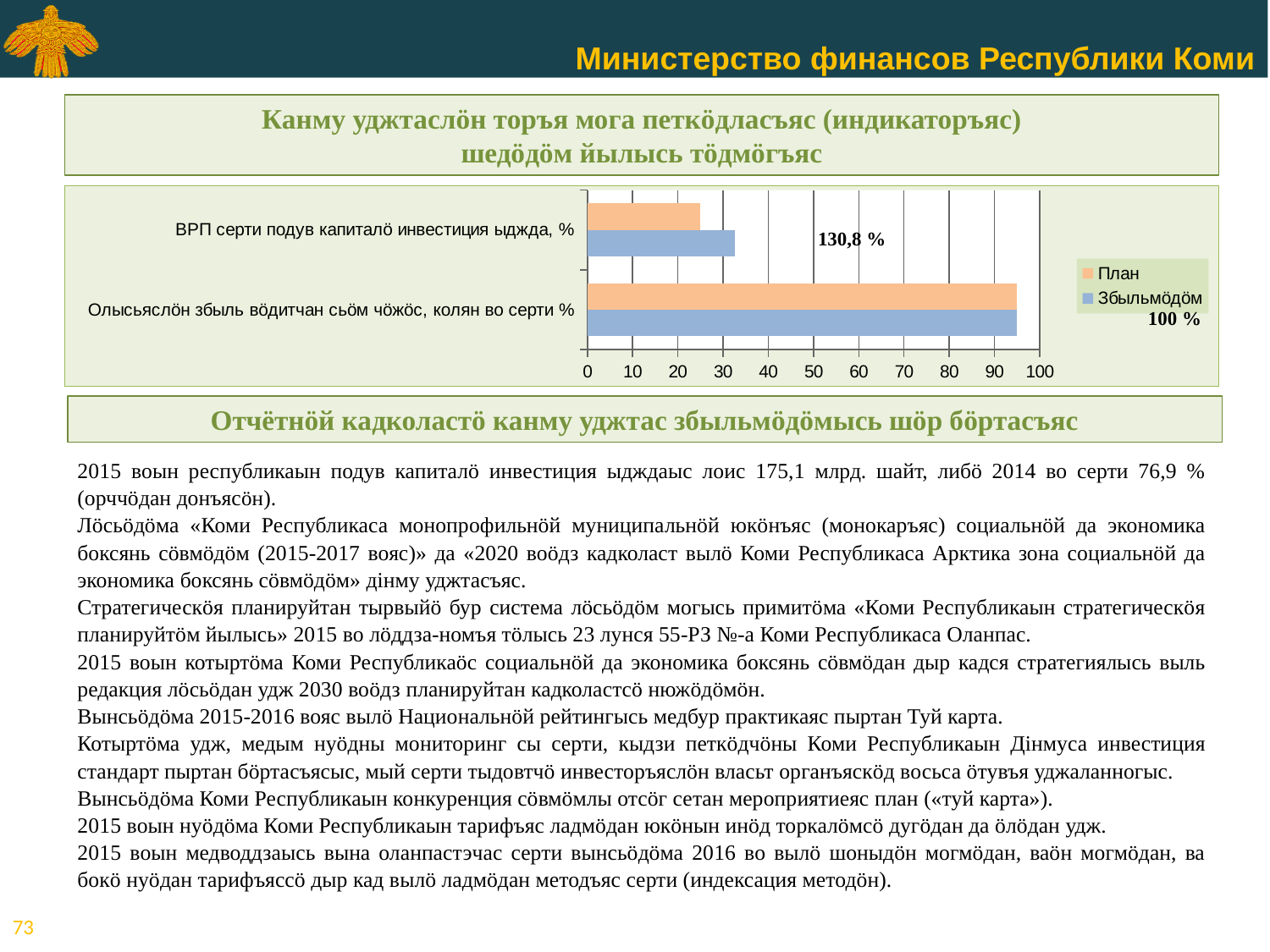
For the category 'ВРП серти подув капиталö инвестиция ыджда, %', which series has the larger value, План or Збыльмöдöм? Збыльмöдöм What percentage annotation is printed next to the bars for 'ВРП серти подув капиталö инвестиция ыджда, %'? 130,8 % How many series does the chart legend list? 2 Is the Збыльмöдöм value for 'Олысьяслöн збыль вöдитчан сьöм чöжöс, колян во серти %' greater or less than 80? greater What are the two series named in the chart legend? План and Збыльмöдöм What kind of chart is shown on the slide? bar chart Which category has the lowest План value? ВРП серти подув капиталö инвестиция ыджда, % Is the Збыльмöдöм value for 'ВРП серти подув капиталö инвестиция ыджда, %' greater or less than 30? greater Is the План value for 'ВРП серти подув капиталö инвестиция ыджда, %' greater or less than 30? less How many categories are shown on the chart? 2 Which category has the higher Збыльмöдöм value? Олысьяслöн збыль вöдитчан сьöм чöжöс, колян во серти %